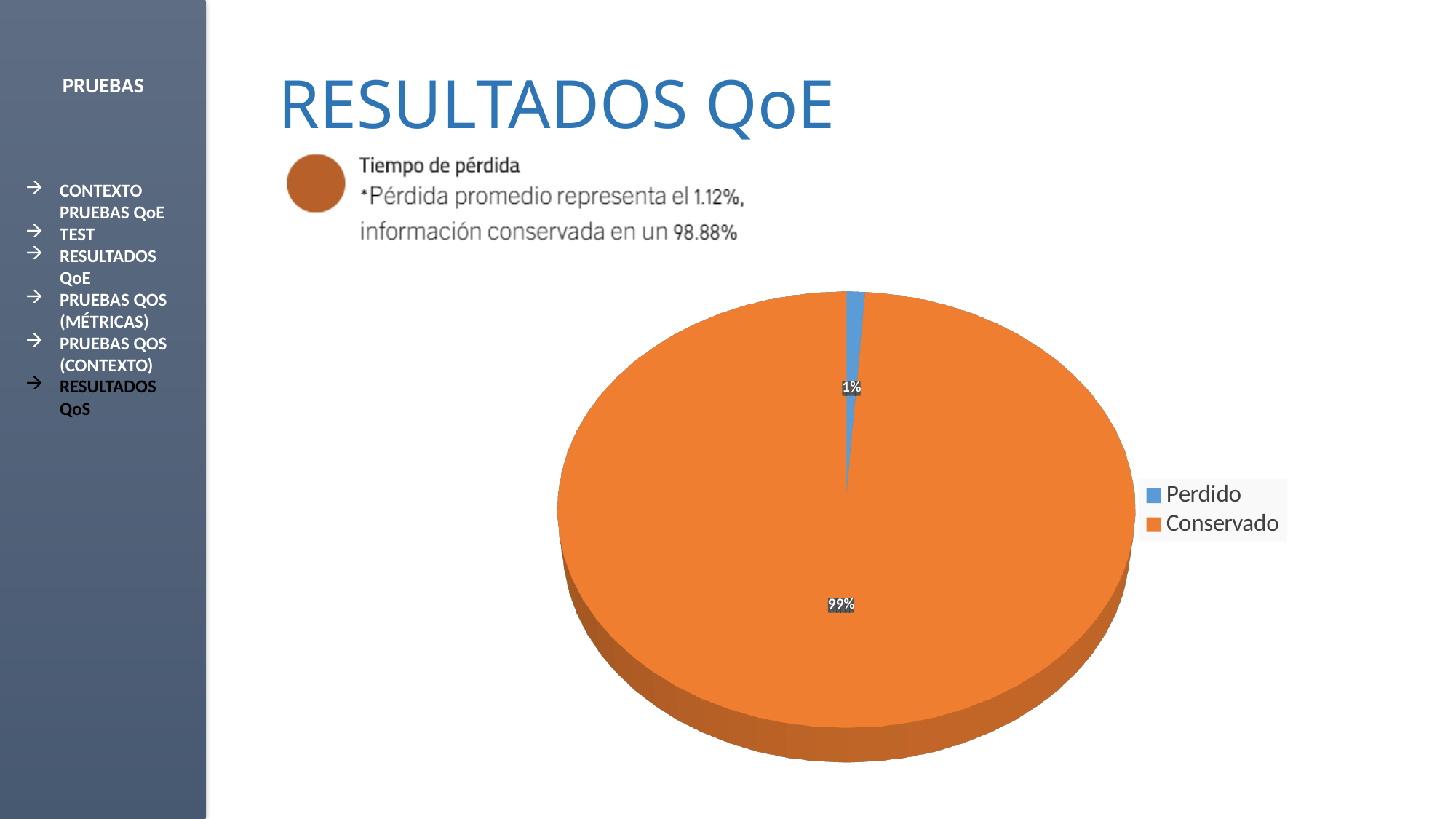
How many entries does the legend list? 2 What share of the pie does the Conservado slice represent? 99% What colour is the Perdido slice in the pie chart? blue How many slices does the pie chart have? 2 Which slice of the pie is the smallest? Perdido What share of the pie does the Perdido slice represent? 1% Which is larger, the Perdido slice or the Conservado slice? Conservado What colour is the Conservado slice in the pie chart? orange Which slice of the pie is the largest? Conservado What is the difference in percentage points between the Conservado and Perdido slices? 98% What kind of chart is shown on the slide? pie chart